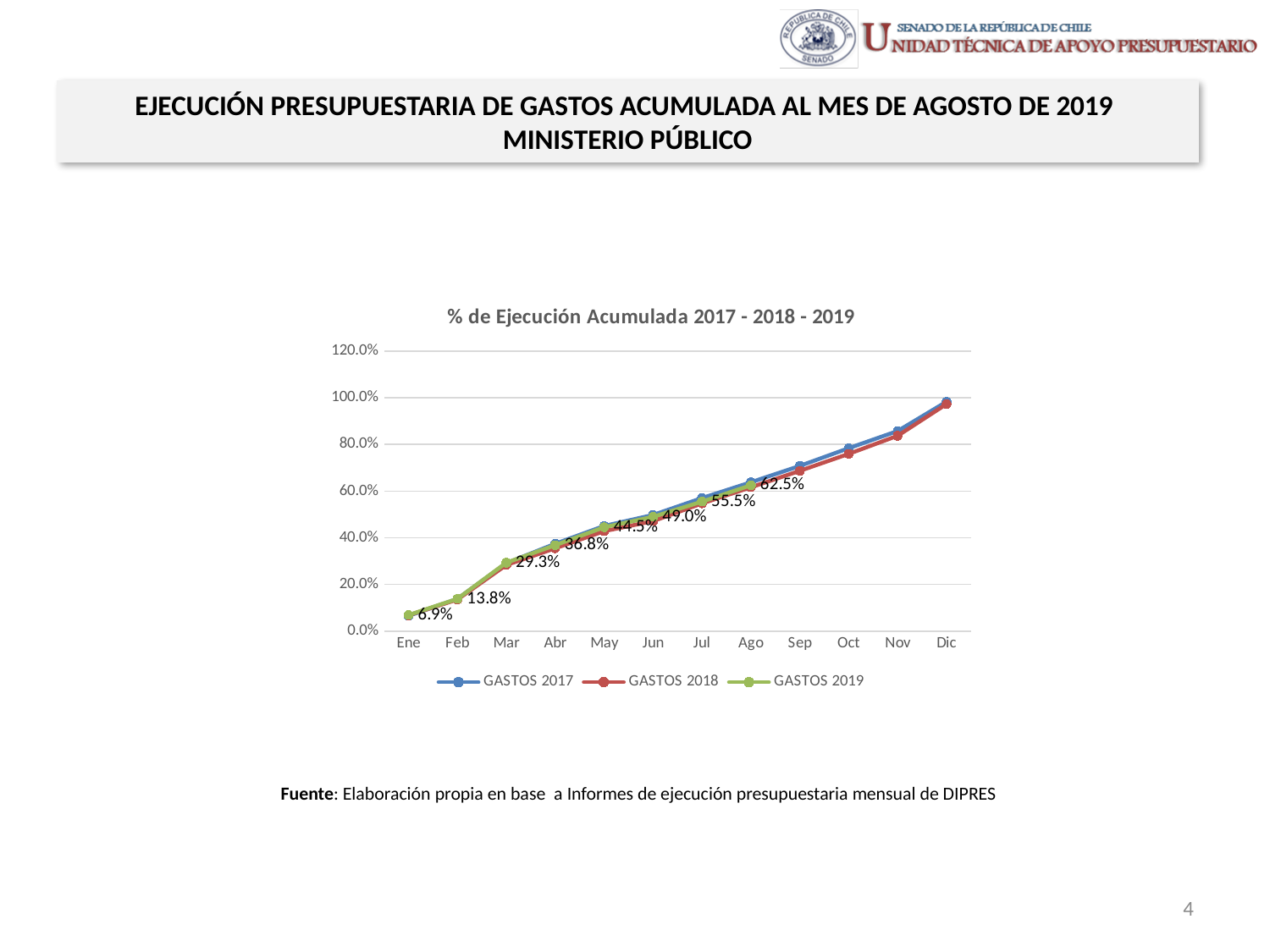
What is the value for GASTOS 2019 in Ene? 6.9% Is the value for GASTOS 2017 in Dic greater or less than 80.0%? greater How many series does the legend list? 3 Do the GASTOS 2019 values rise or fall from Ene to Ago? rise What is the difference between the GASTOS 2019 values for Ago and Jul? 7.0% What is the title of the chart? % de Ejecución Acumulada 2017 - 2018 - 2019 What is the value for GASTOS 2019 in Ago? 62.5% Is the value for GASTOS 2018 in Feb greater or less than 20.0%? less What is the value for GASTOS 2019 in Mar? 29.3% What is the value for GASTOS 2019 in May? 44.5% How many months are shown on the x axis? 12 What type of chart is shown on the slide? line chart